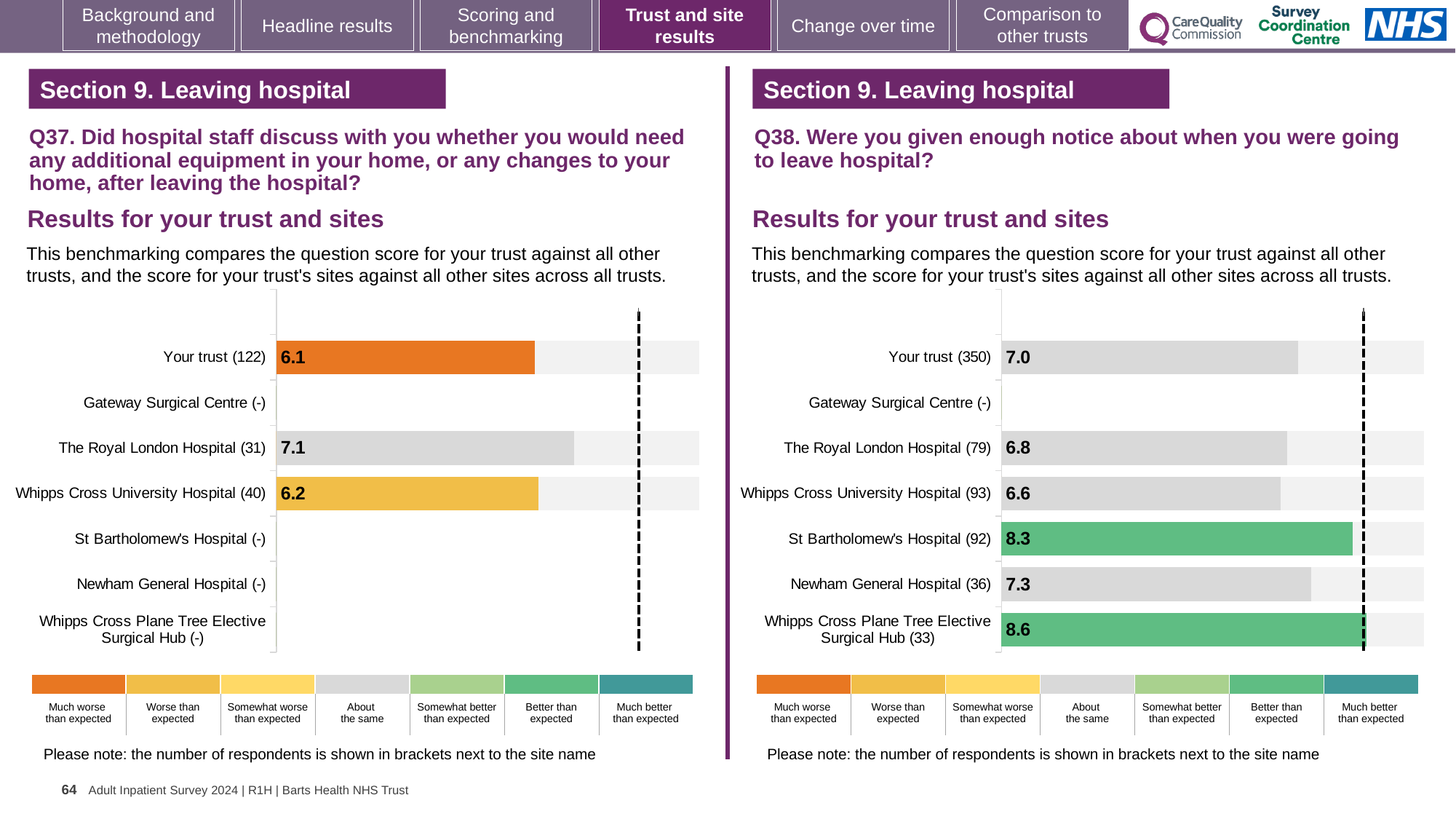
On the Q37 chart (left), what is the score for Your trust? 6.1 On the Q38 chart (right), which site has the highest score? Whipps Cross Plane Tree Elective Surgical Hub On the Q38 chart (right), which is larger: the score for Your trust or the score for The Royal London Hospital? Your trust On the Q38 chart (right), what is the difference between the scores for Whipps Cross Plane Tree Elective Surgical Hub and Your trust? 1.6 On the Q37 chart (left), which site with a plotted score has the highest value? The Royal London Hospital What type of chart is used on the Q38 chart (right)? Bar chart On the Q37 chart (left), what is the difference between the scores for The Royal London Hospital and Whipps Cross University Hospital? 0.9 On the Q38 chart (right), what is the score for St Bartholomew's Hospital? 8.3 On the Q37 chart (left), what is the score for The Royal London Hospital? 7.1 On the Q37 chart (left), how many respondents are shown for Your trust? 122 On the Q38 chart (right), which site with a plotted score has the lowest value? Whipps Cross University Hospital On the Q38 chart (right), what is the score for Newham General Hospital? 7.3